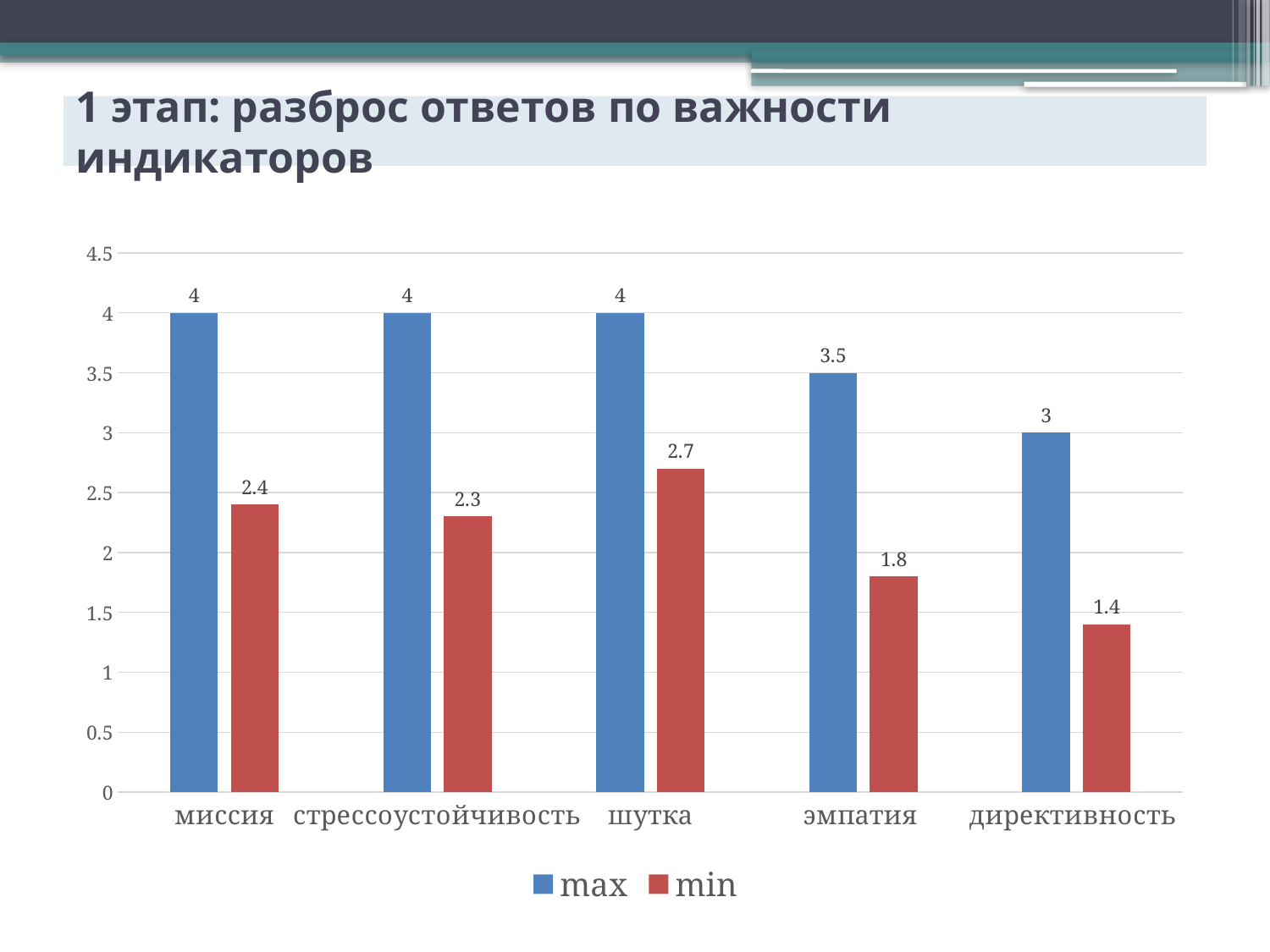
What colour are the bars for the min series? red Which is larger: the min value for миссия or the min value for стрессоустойчивость? миссия Which category has the lowest max value? директивность What is the difference between the max and min values for эмпатия? 1.7 What is the min value for шутка? 2.7 What is the min value for директивность? 1.4 How many categories are shown on the x axis? 5 How many series does the legend list? 2 What is the max value for миссия? 4 What kind of chart is shown on the slide? bar chart Which category has the highest min value? шутка What is the max value for эмпатия? 3.5